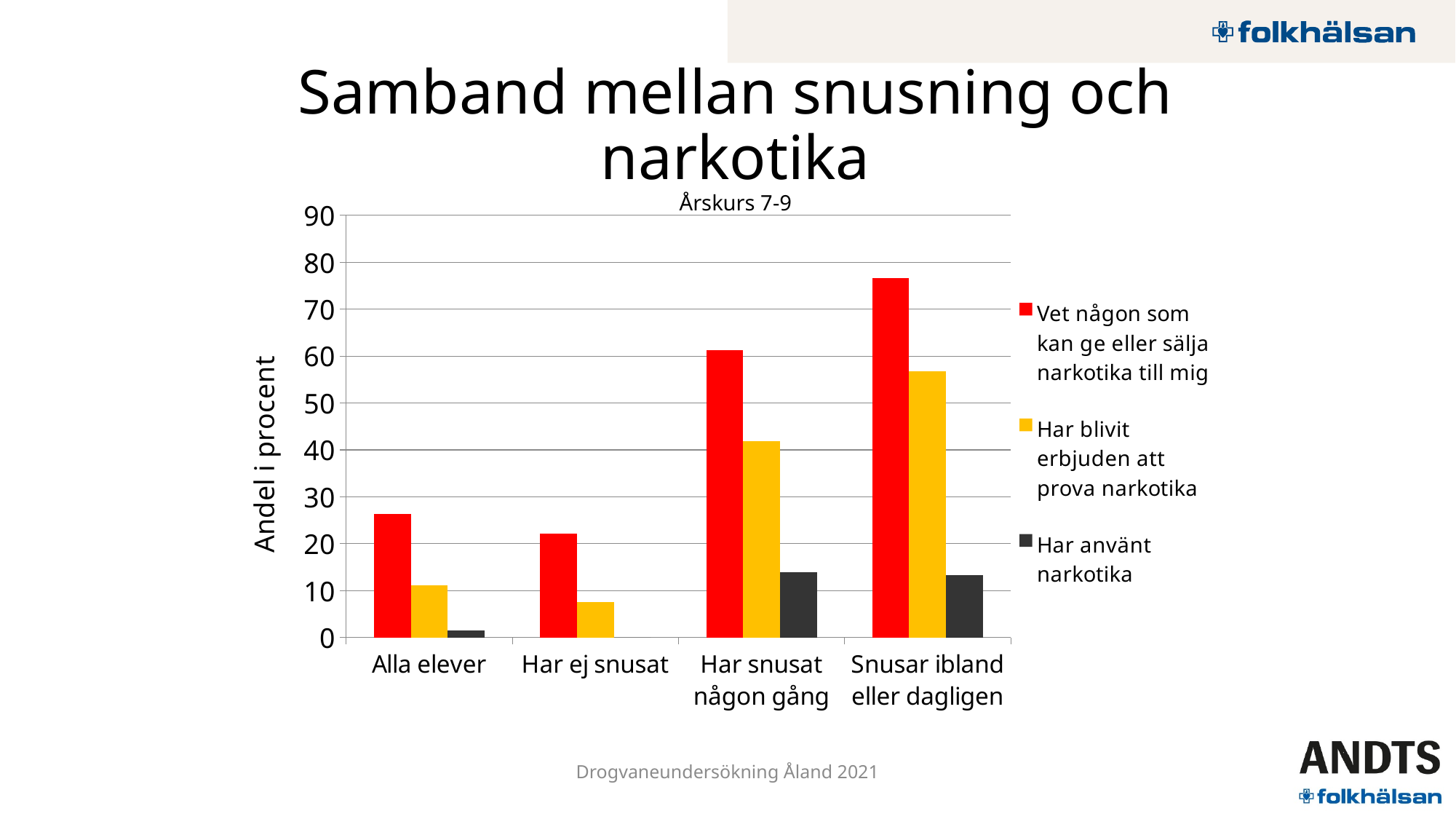
How many categories are shown on the x axis of the chart? 4 Is the value for 'Vet någon som kan ge eller sälja narkotika till mig' in the 'Snusar ibland eller dagligen' category greater or less than 70? greater Which category has the lowest value for 'Vet någon som kan ge eller sälja narkotika till mig'? Har ej snusat What is the title printed above the chart's plot area? Årskurs 7-9 Which category has the highest value for 'Har blivit erbjuden att prova narkotika'? Snusar ibland eller dagligen How many series does the chart's legend list? 3 For 'Har blivit erbjuden att prova narkotika', which is larger: 'Har snusat någon gång' or 'Snusar ibland eller dagligen'? Snusar ibland eller dagligen What is the label on the chart's vertical axis? Andel i procent Is the value for 'Har använt narkotika' in the 'Har snusat någon gång' category greater or less than 10? greater Which category has the highest value for 'Vet någon som kan ge eller sälja narkotika till mig'? Snusar ibland eller dagligen Is the value for 'Vet någon som kan ge eller sälja narkotika till mig' in the 'Alla elever' category greater or less than 30? less What kind of chart is shown on the slide? bar chart